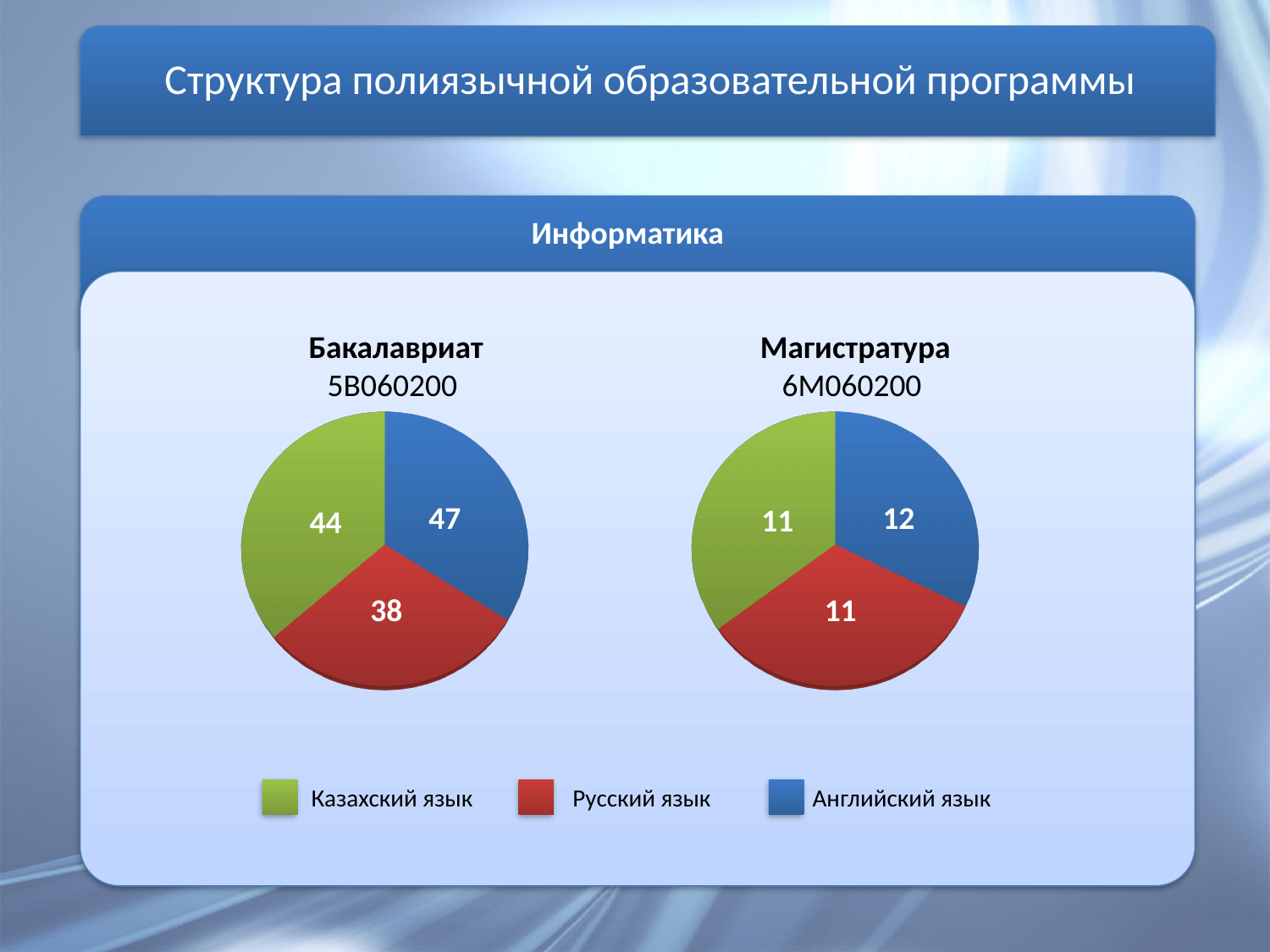
In the Магистратура 6M060200 pie chart, which language has the largest slice? Английский язык In the Бакалавриат 5B060200 pie chart, what is the value for Английский язык? 47 How many slices does the Бакалавриат 5B060200 pie chart have? 3 In the Бакалавриат 5B060200 pie chart, which language has the smallest slice? Русский язык In the Бакалавриат 5B060200 pie chart, which language has the largest slice? Английский язык What is the total of all slices in the Магистратура 6M060200 pie chart? 34 In the Магистратура 6M060200 pie chart, what is the value for Казахский язык? 11 In the Бакалавриат 5B060200 pie chart, what is the difference between the values for Английский язык and Русский язык? 9 What type of chart is used for Бакалавриат 5B060200 and Магистратура 6M060200? Pie chart In the Магистратура 6M060200 pie chart, what is the value for Английский язык? 12 In the Бакалавриат 5B060200 pie chart, what is the value for Русский язык? 38 In the Бакалавриат 5B060200 pie chart, which is larger: Казахский язык or Русский язык? Казахский язык